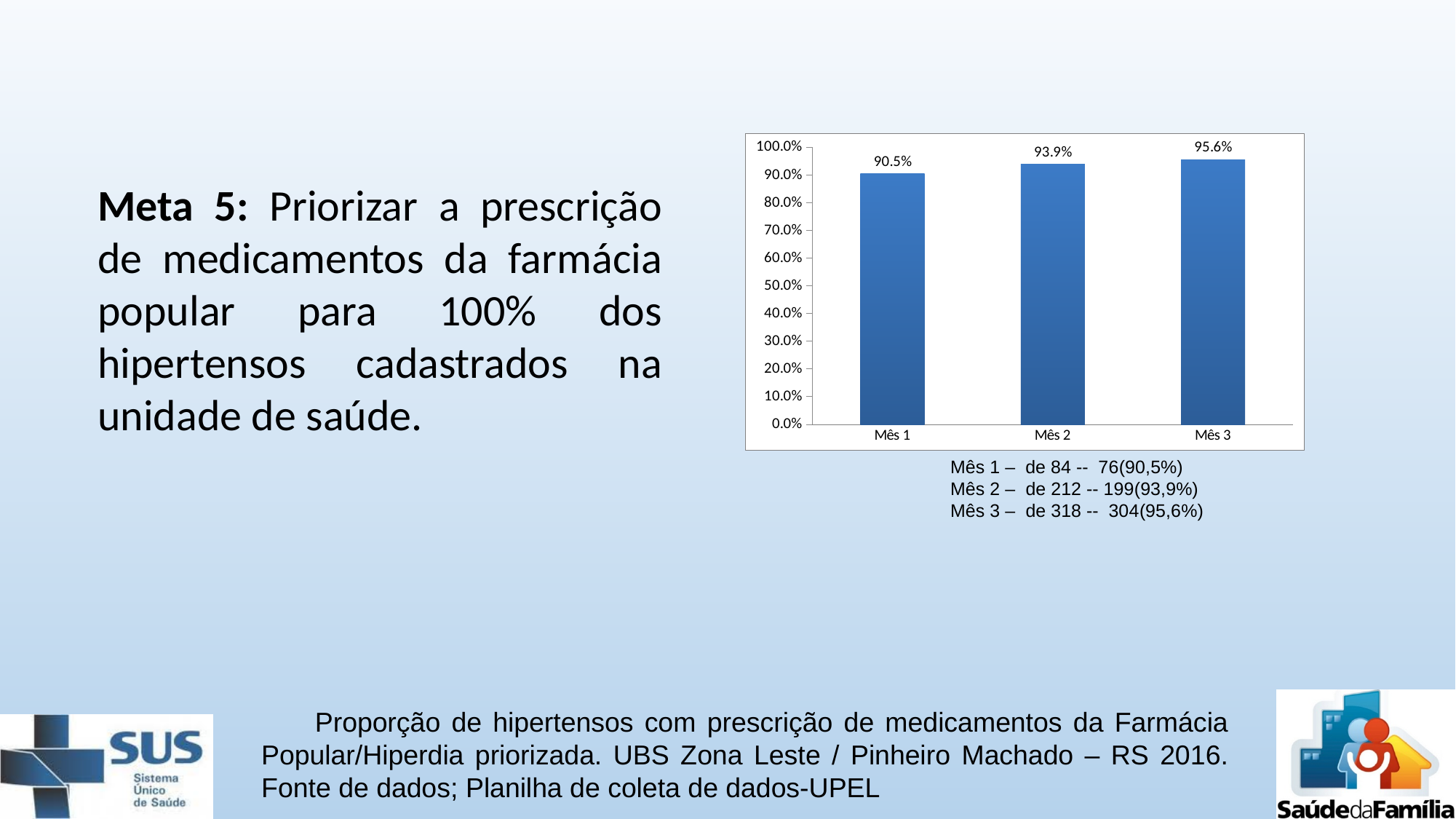
What is the value for Mês 1? 90.5% What is the value for Mês 2? 93.9% What is the difference between the values for Mês 2 and Mês 1? 3.4% Do the values rise or fall from Mês 1 to Mês 3? Rise Is the value for Mês 1 greater or less than 80.0%? greater Which is larger, the value for Mês 2 or the value for Mês 3? Mês 3 What is the value for Mês 3? 95.6% Which month has the lowest value? Mês 1 How many bars are shown in the chart? 3 Which month has the highest value? Mês 3 What is the difference between the values for Mês 3 and Mês 1? 5.1% What kind of chart is shown on the slide? Bar chart